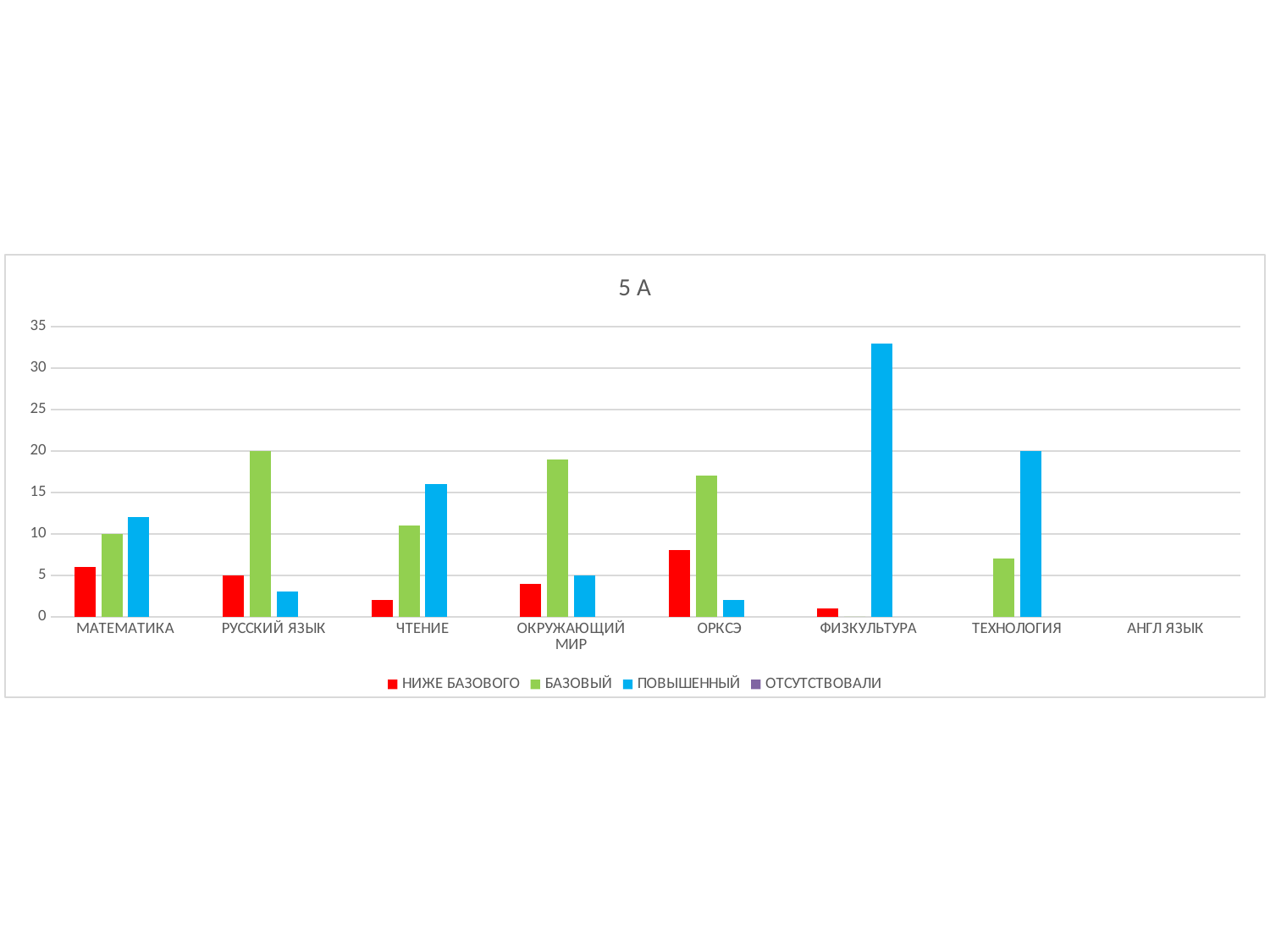
What is the title of the chart? 5 А Is the БАЗОВЫЙ value for ОКРУЖАЮЩИЙ МИР greater or less than 15? greater Is the ПОВЫШЕННЫЙ value for ФИЗКУЛЬТУРА greater or less than 30? greater What is the БАЗОВЫЙ value for МАТЕМАТИКА? 10 Which subject has the highest НИЖЕ БАЗОВОГО value? ОРКСЭ What is the БАЗОВЫЙ value for РУССКИЙ ЯЗЫК? 20 How many series does the legend list? 4 What is the ПОВЫШЕННЫЙ value for ТЕХНОЛОГИЯ? 20 For ЧТЕНИЕ, which is larger: the БАЗОВЫЙ value or the ПОВЫШЕННЫЙ value? ПОВЫШЕННЫЙ Which subject has the highest ПОВЫШЕННЫЙ value? ФИЗКУЛЬТУРА What kind of chart is shown on the slide? bar chart How many subject categories are shown on the x axis? 8